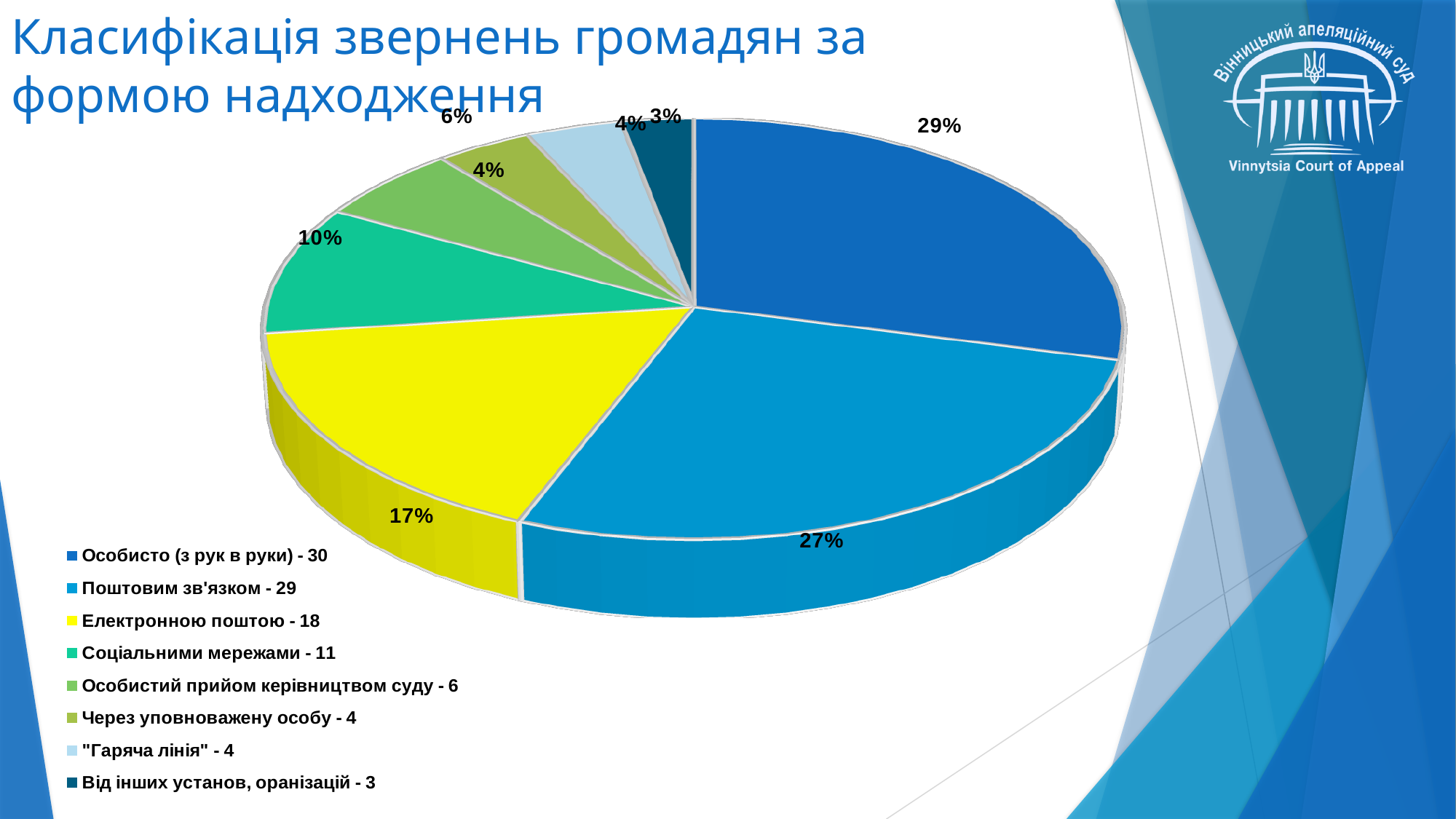
What share of the pie does the slice for "Електронною поштою" represent? 17% According to the legend, what is the difference between the number of appeals received "Особисто (з рук в руки)" and "Поштовим зв'язком"? 1 What share of the pie does the slice for "Особисто (з рук в руки)" represent? 29% What share of the pie does the slice for "Поштовим зв'язком" represent? 27% According to the legend, how many appeals were received via "Соціальними мережами"? 11 Which is larger: the slice for "Електронною поштою" or the slice for "Соціальними мережами"? Електронною поштою Which category has the largest slice of the pie? Особисто (з рук в руки) What kind of chart is shown on the slide? pie chart Which category has the smallest slice of the pie? Від інших установ, оранізацій What is the title of the chart on the slide? Класифікація звернень громадян за формою надходження How many slices does the pie chart have? 8